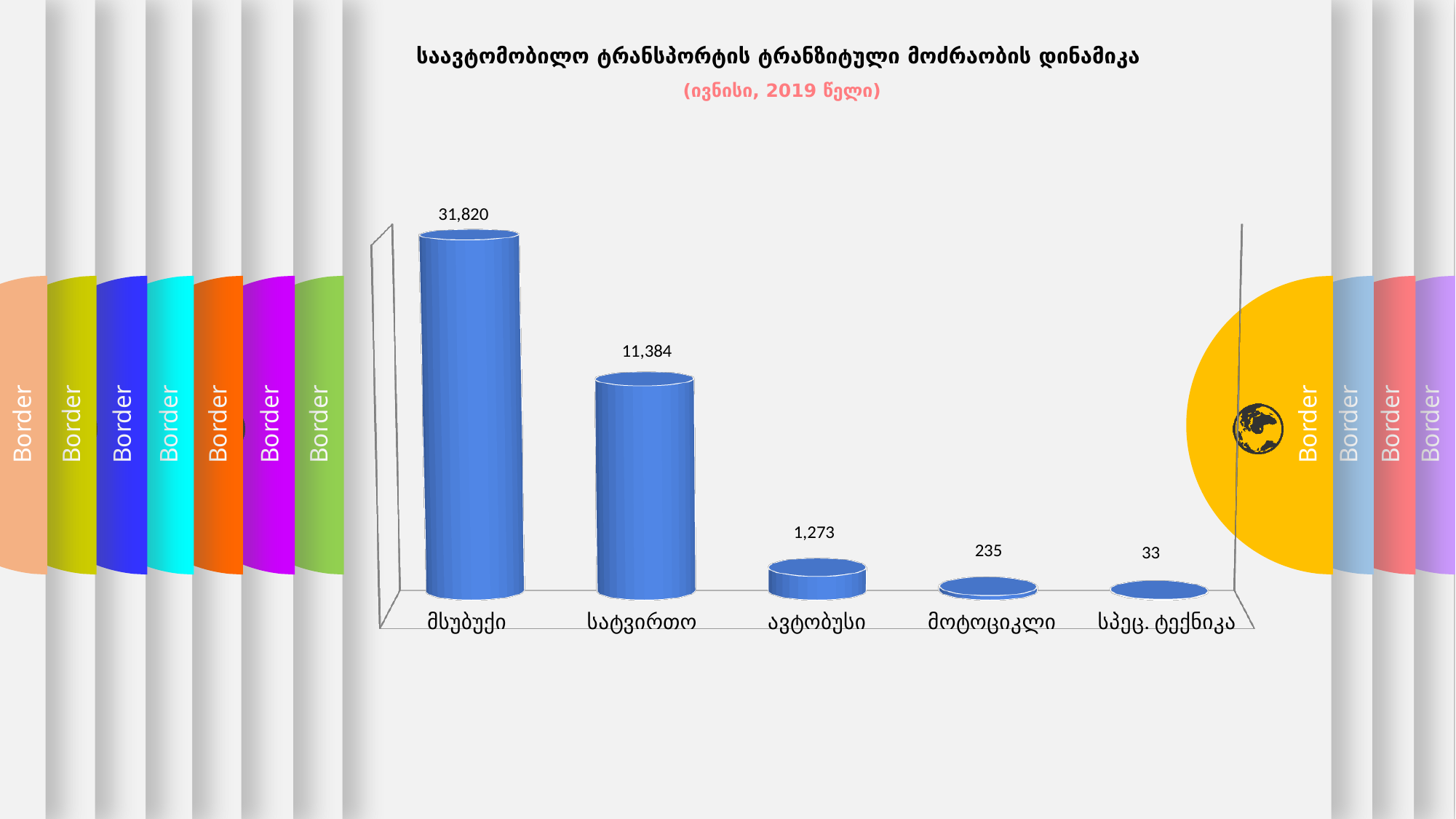
What period is given in the chart's subtitle? ივნისი, 2019 წელი What is the value for მოტოციკლი? 235 Which is larger, the value for ავტობუსი or the value for მოტოციკლი? ავტობუსი How many categories are shown on the x axis? 5 Which category has the lowest value? სპეც. ტექნიკა What is the value for სპეც. ტექნიკა? 33 What is the value for მსუბუქი? 31,820 What kind of chart is shown on the slide? Bar chart What is the difference between the values for მსუბუქი and სატვირთო? 20,436 Which category has the highest value? მსუბუქი What is the value for სატვირთო? 11,384 What is the value for ავტობუსი? 1,273